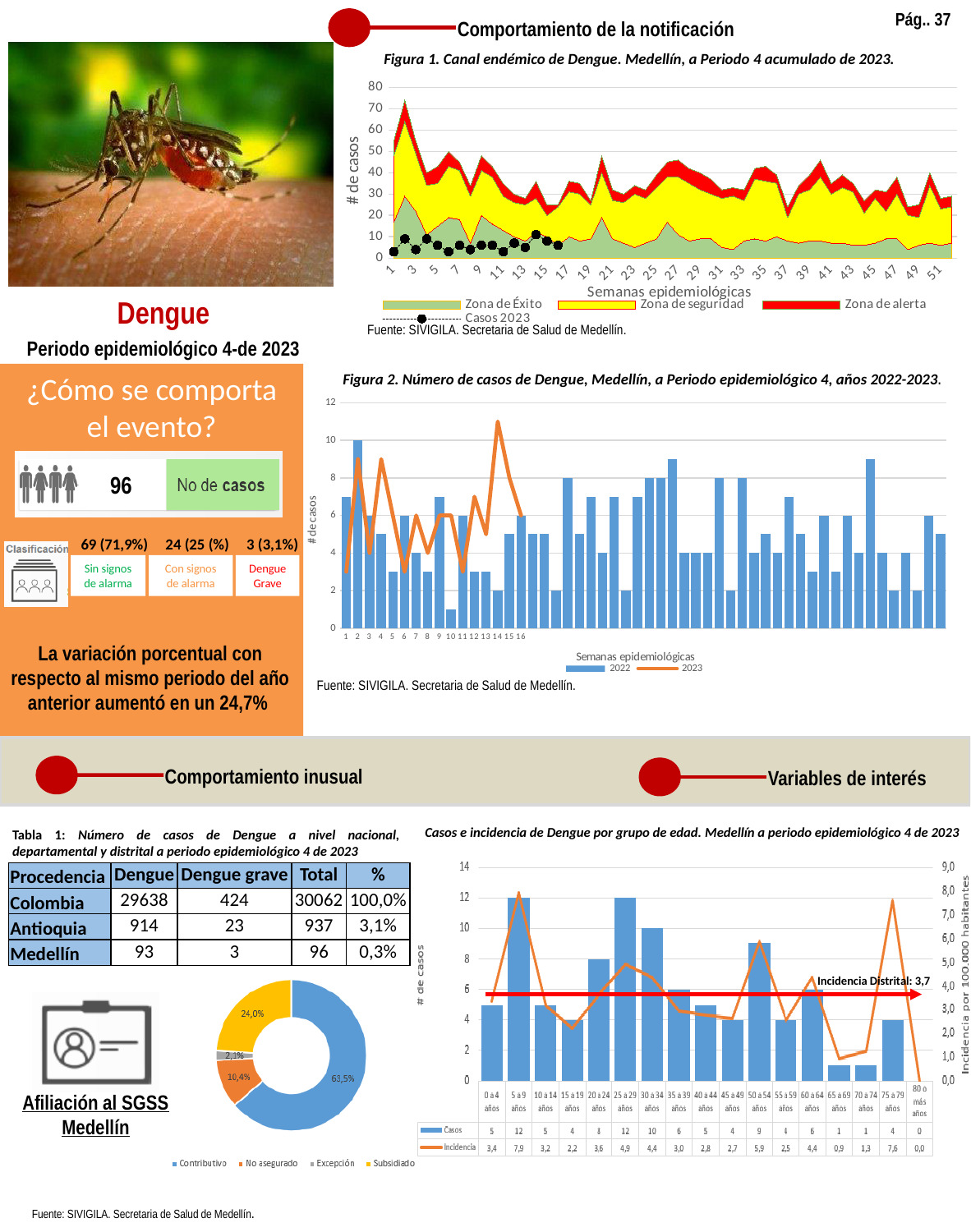
In the 'Casos e incidencia de Dengue por grupo de edad' chart, which has more cases: 50 a 54 años or 55 a 59 años? 50 a 54 años In the 'Casos e incidencia de Dengue por grupo de edad' chart, which age group has the lowest number of cases? 80 o más años In Figura 2, is the 2022 value for week 2 greater or less than 8? greater In the 'Casos e incidencia de Dengue por grupo de edad' chart, how many cases are reported for the 30 a 34 años age group? 10 In the 'Casos e incidencia de Dengue por grupo de edad' chart, what value is given for the Incidencia Distrital? 3,7 In the 'Afiliación al SGSS Medellín' donut chart, which category has the smallest share? Excepción In the 'Casos e incidencia de Dengue por grupo de edad' chart, which age group has the highest incidence? 5 a 9 años In the 'Afiliación al SGSS Medellín' donut chart, what share does Contributivo represent? 63,5% In Figura 2, how many series does the legend list? 2 In Figura 1, how many entries does the legend list? 4 In the 'Casos e incidencia de Dengue por grupo de edad' chart, what is the incidence for the 75 a 79 años age group? 7,6 In the 'Casos e incidencia de Dengue por grupo de edad' chart, what is the difference in cases between the 25 a 29 años and 35 a 39 años groups? 6